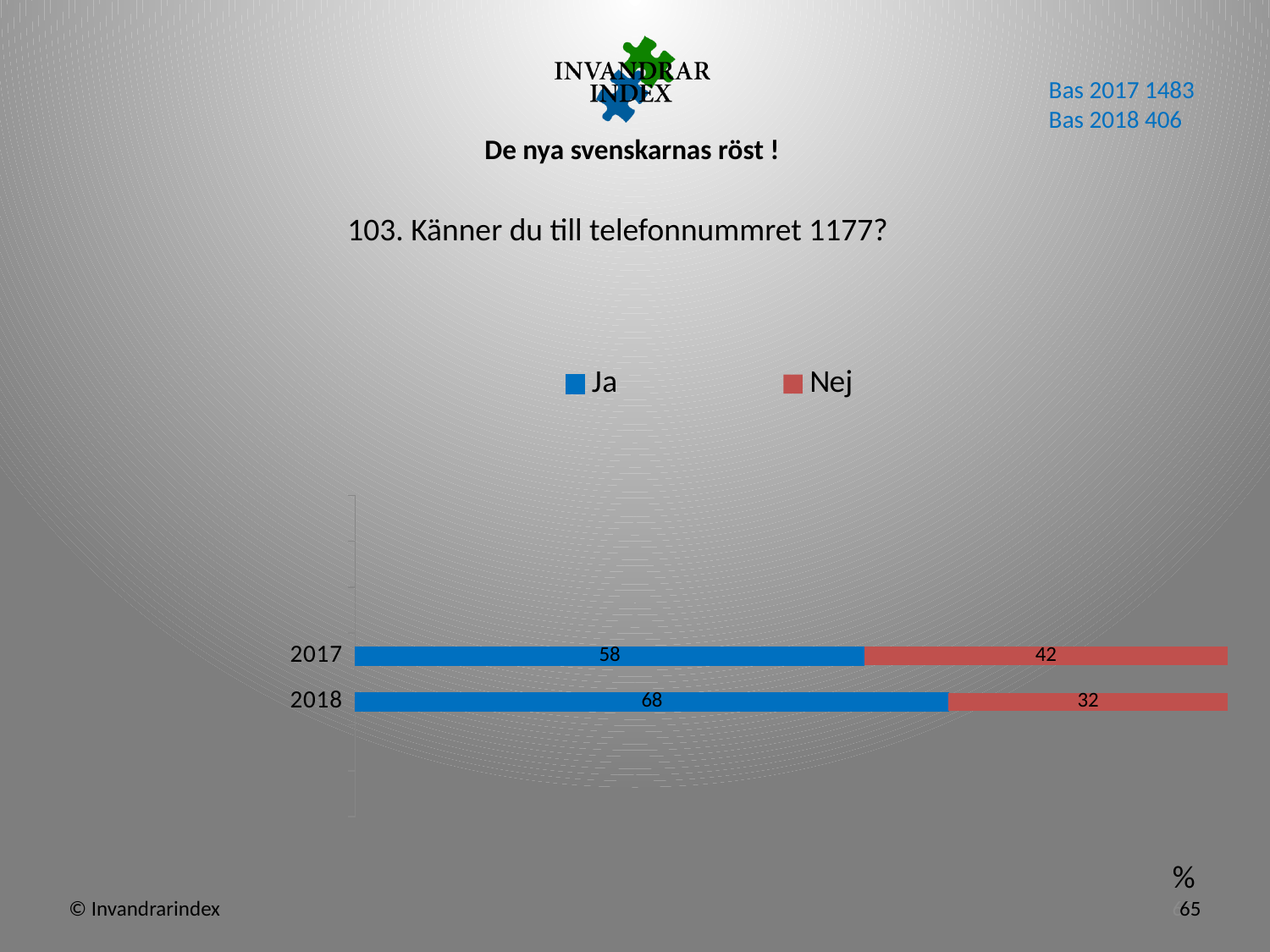
What is the difference between the Ja values for 2018 and 2017? 10 What is the total of the stacked bar for 2018? 100 What is the value for Nej in 2018? 32 Which year has the lower value for Nej? 2018 How many series does the legend list? 2 What is the value for Ja in 2017? 58 What kind of chart is shown on the slide? stacked bar chart How many years are shown on the chart? 2 What is the value for Ja in 2018? 68 What is the value for Nej in 2017? 42 Is the Nej value for 2017 larger or smaller than the Nej value for 2018? larger Which year has the higher value for Ja? 2018